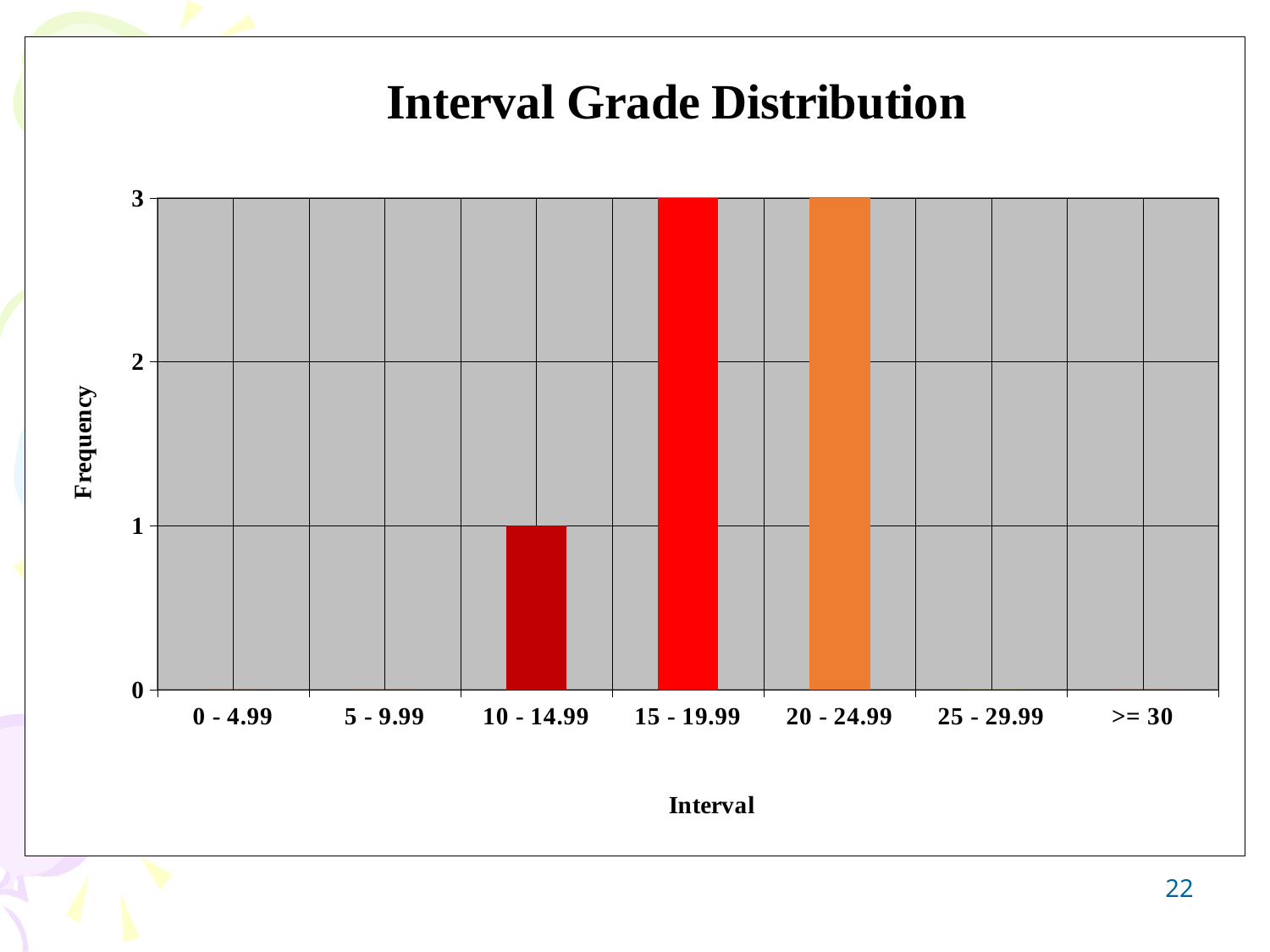
What is the frequency for the 10 - 14.99 interval? 1 What is the frequency for the 15 - 19.99 interval? 3 Which interval has the lowest non-zero frequency? 10 - 14.99 What is the title of the chart? Interval Grade Distribution What is the frequency for the 20 - 24.99 interval? 3 Which has the larger frequency, the 10 - 14.99 interval or the 15 - 19.99 interval? 15 - 19.99 What is the difference in frequency between the 20 - 24.99 interval and the 10 - 14.99 interval? 2 What is the label of the y axis? Frequency What type of chart is shown on the slide? bar chart How many interval categories are shown on the x axis? 7 Is the frequency for the 10 - 14.99 interval greater or less than 2? less What is the frequency for the 0 - 4.99 interval? 0